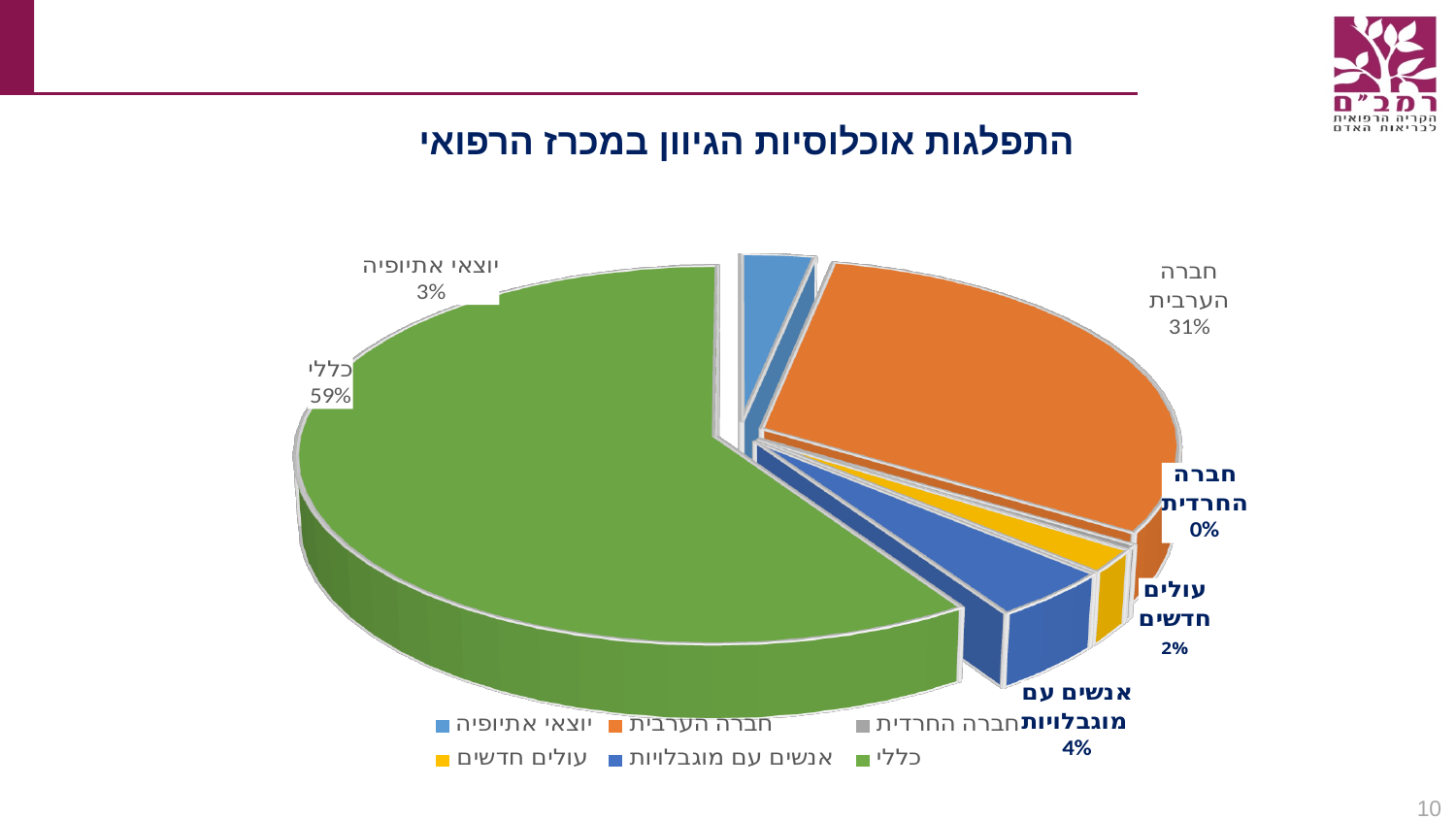
What percentage is shown for חברה החרדית? 0% What is the difference in percentage points between כללי and חברה הערבית? 28 What percentage of the pie is the כללי slice? 59% Which category has the largest share of the pie? כללי Which category has the smallest share of the pie? חברה החרדית What percentage is shown for חברה הערבית? 31% What kind of chart is shown on the slide? pie chart What percentage is shown for אנשים עם מוגבלויות? 4% What is the title of the chart? התפלגות אוכלוסיות הגיוון במכרז הרפואי How many categories does the legend list? 6 What percentage is shown for יוצאי אתיופיה? 3% What percentage is shown for עולים חדשים? 2%